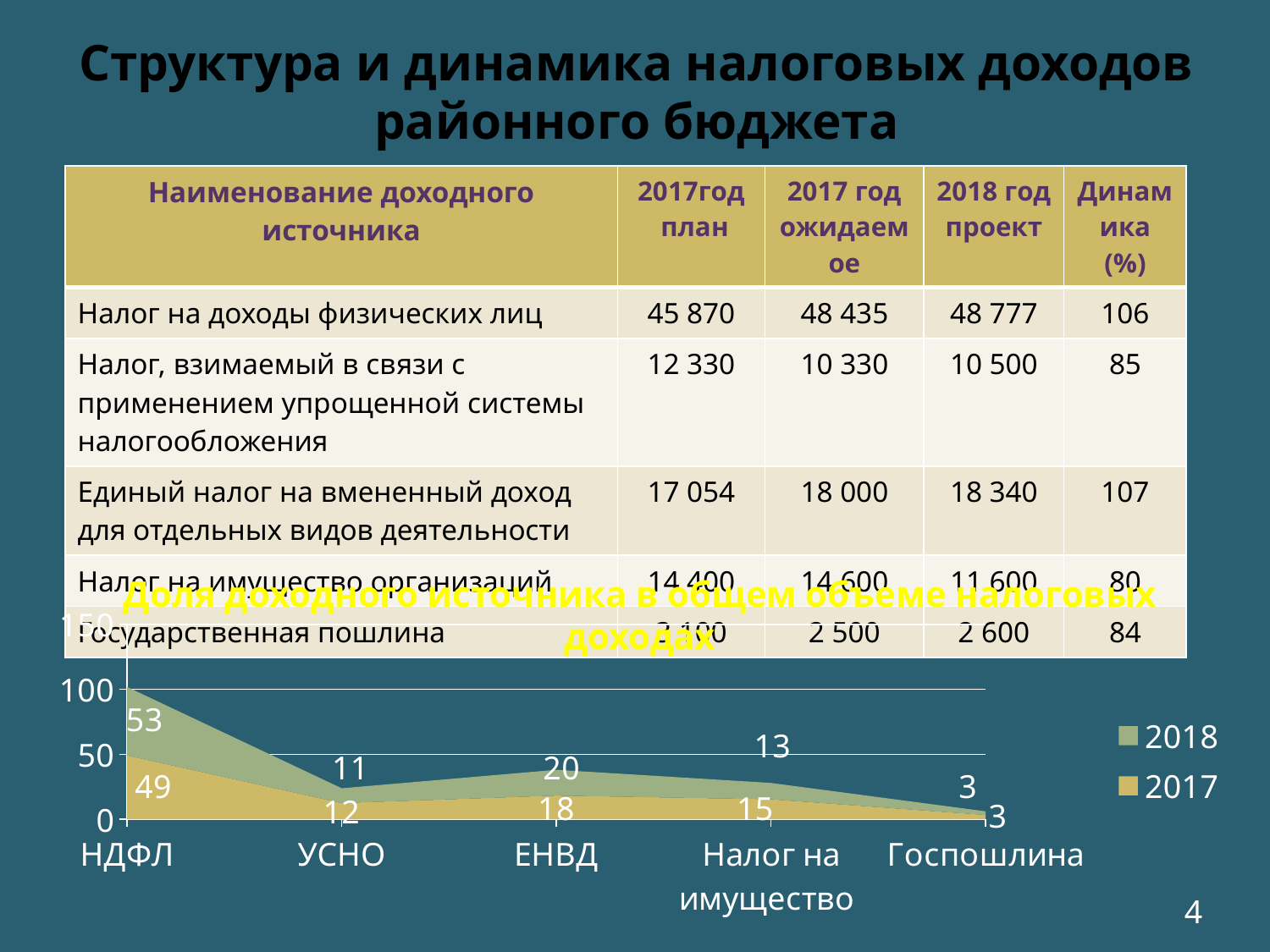
Which category has the highest 2018 value in the chart? НДФЛ Which category has the lowest 2017 value in the chart? Госпошлина What is the 2018 value for ЕНВД in the chart? 20 What is the 2017 value for НДФЛ in the chart? 49 What is the total of the stacked 2017 and 2018 values for ЕНВД in the chart? 38 What is the 2017 value for Налог на имущество in the chart? 15 How many series does the chart legend list? 2 Which is larger in the chart: the 2017 value for УСНО or the 2018 value for УСНО? 2017 value for УСНО What is the 2018 value for НДФЛ in the chart? 53 How many categories are shown on the x axis of the chart? 5 What kind of chart is shown at the bottom of the slide? stacked area chart What is the difference between the 2018 and 2017 values for НДФЛ in the chart? 4